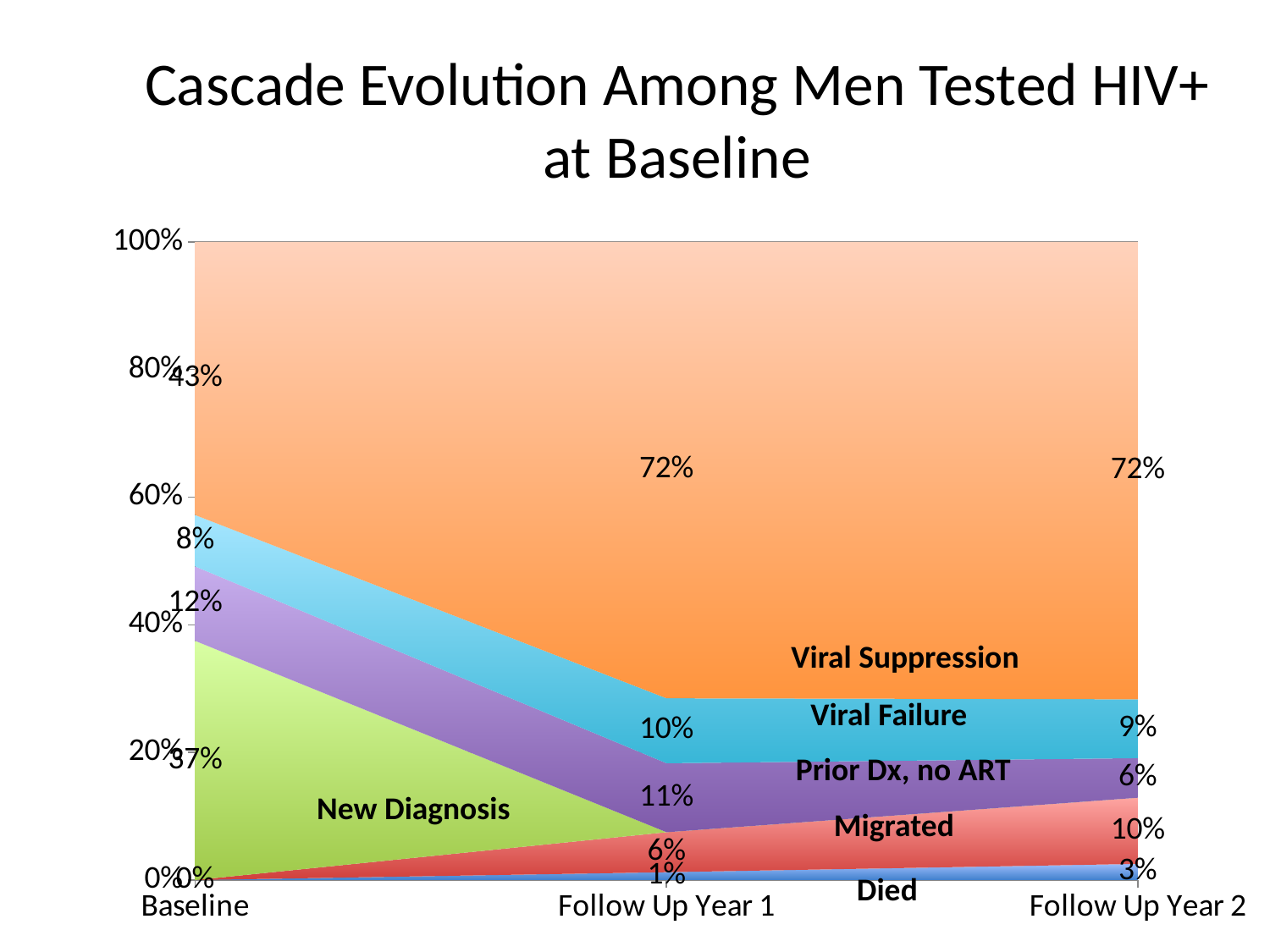
What is the Viral Suppression value at Follow Up Year 1? 72% What is the Died value at Follow Up Year 1? 1% How many time points are shown on the x axis? 3 What is the Viral Suppression value at Baseline? 43% What type of chart is shown on the slide? stacked area chart What is the Viral Failure value at Follow Up Year 2? 9% What is the title of the chart? Cascade Evolution Among Men Tested HIV+ at Baseline By how much did Viral Suppression increase from Baseline to Follow Up Year 1? 29% Which is larger at Follow Up Year 2: Prior Dx, no ART or Migrated? Migrated What is the Migrated value at Follow Up Year 2? 10% Does the Viral Suppression share rise or fall from Baseline to Follow Up Year 1? rise What is the New Diagnosis value at Baseline? 37%